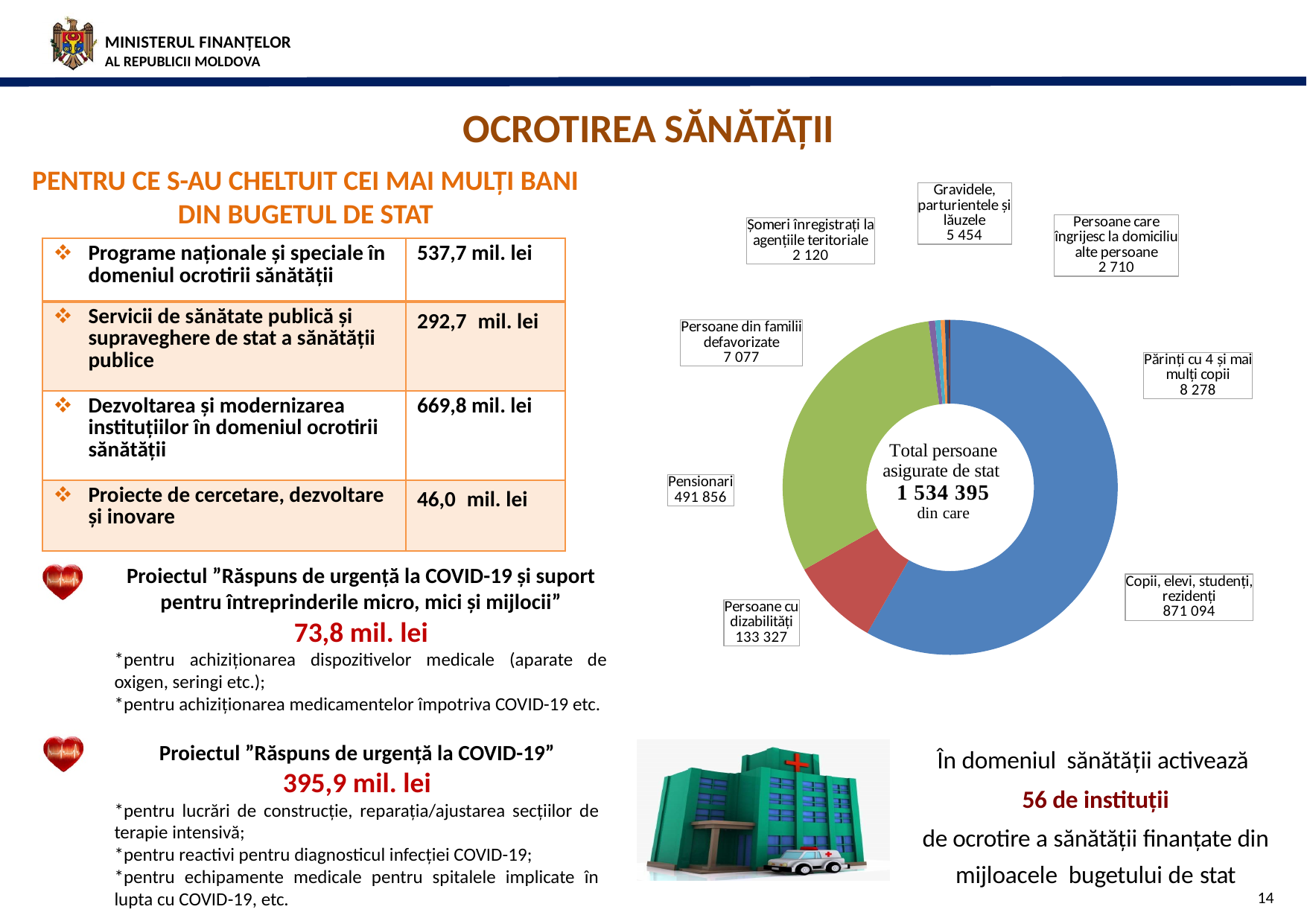
Which category in the donut chart has the largest value? Copii, elevi, studenți, rezidenți In the donut chart, how many persons are in the category 'Pensionari'? 491 856 In the donut chart, what is the value for 'Persoane cu dizabilități'? 133 327 In the donut chart, what is the value for 'Copii, elevi, studenți, rezidenți'? 871 094 How many categories are labelled in the donut chart? 8 In the donut chart, what is the difference between 'Părinți cu 4 și mai mulți copii' and 'Persoane din familii defavorizate'? 1 201 What type of chart is shown on the right side of the slide? Pie (donut) chart In the donut chart, which is larger: 'Pensionari' or 'Persoane cu dizabilități'? Pensionari Which category in the donut chart has the smallest value? Șomeri înregistrați la agențiile teritoriale In the donut chart, what is the value for 'Gravidele, parturientele și lăuzele'? 5 454 In the donut chart, what is the difference between 'Copii, elevi, studenți, rezidenți' and 'Pensionari'? 379 238 What is the total number of persons insured by the state shown in the centre of the donut chart? 1 534 395